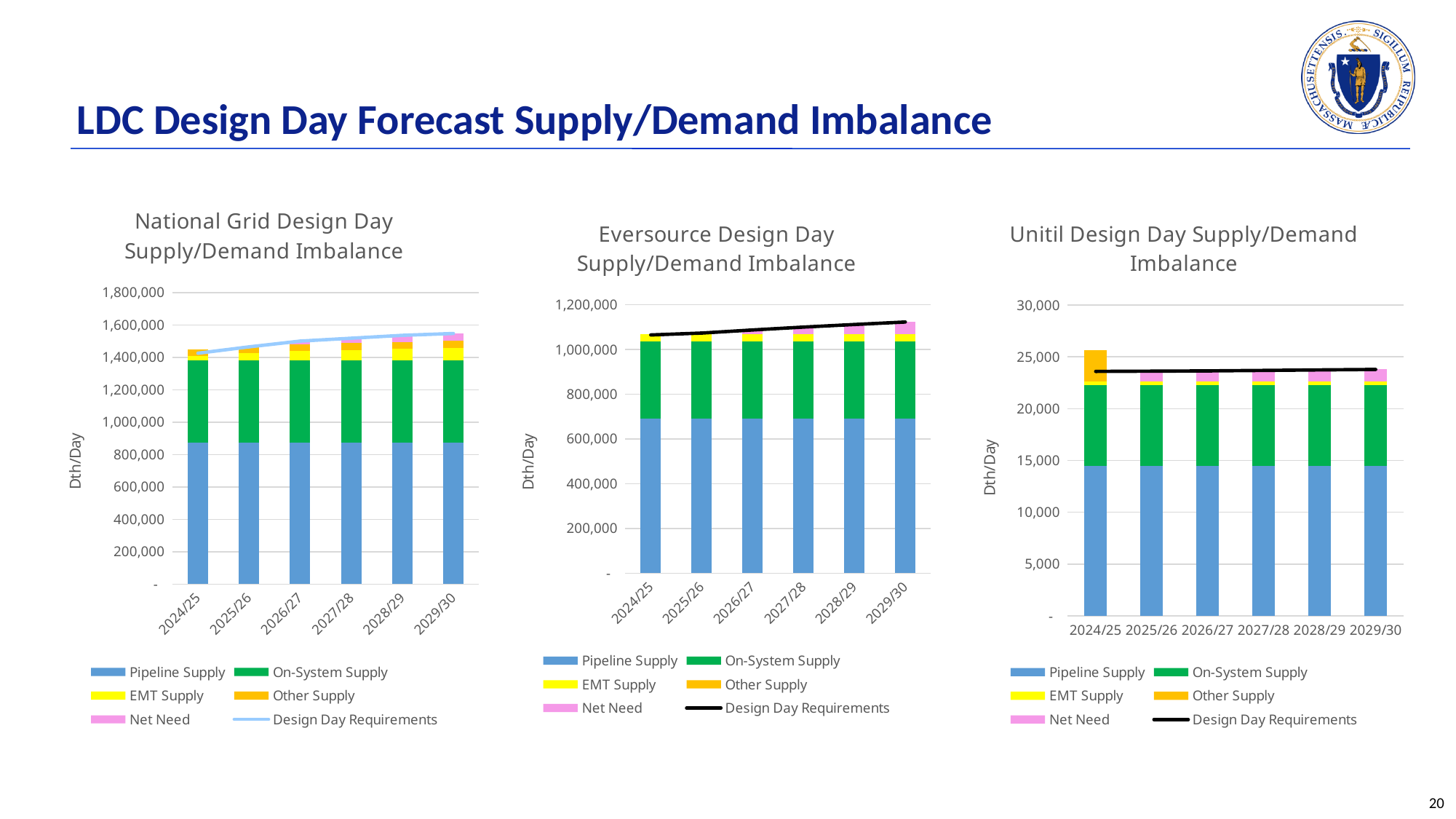
In the Eversource Design Day Supply/Demand Imbalance chart, is the Pipeline Supply value for 2024/25 greater or less than 800,000? less What is the y-axis label on the Unitil Design Day Supply/Demand Imbalance chart? Dth/Day In the National Grid Design Day Supply/Demand Imbalance chart, is the Pipeline Supply value for 2024/25 greater or less than 1,000,000? less In the Eversource Design Day Supply/Demand Imbalance chart, is the Pipeline Supply value for 2029/30 greater or less than 600,000? greater How many years are shown on the x axis of the Eversource Design Day Supply/Demand Imbalance chart? 6 In the National Grid Design Day Supply/Demand Imbalance chart, does the Design Day Requirements line rise or fall from 2024/25 to 2029/30? rise In the Eversource Design Day Supply/Demand Imbalance chart, does the Design Day Requirements line rise or fall from 2024/25 to 2029/30? rise How many series does the legend of the Unitil Design Day Supply/Demand Imbalance chart list? 6 What kind of chart is the National Grid Design Day Supply/Demand Imbalance chart? Stacked bar chart with a line